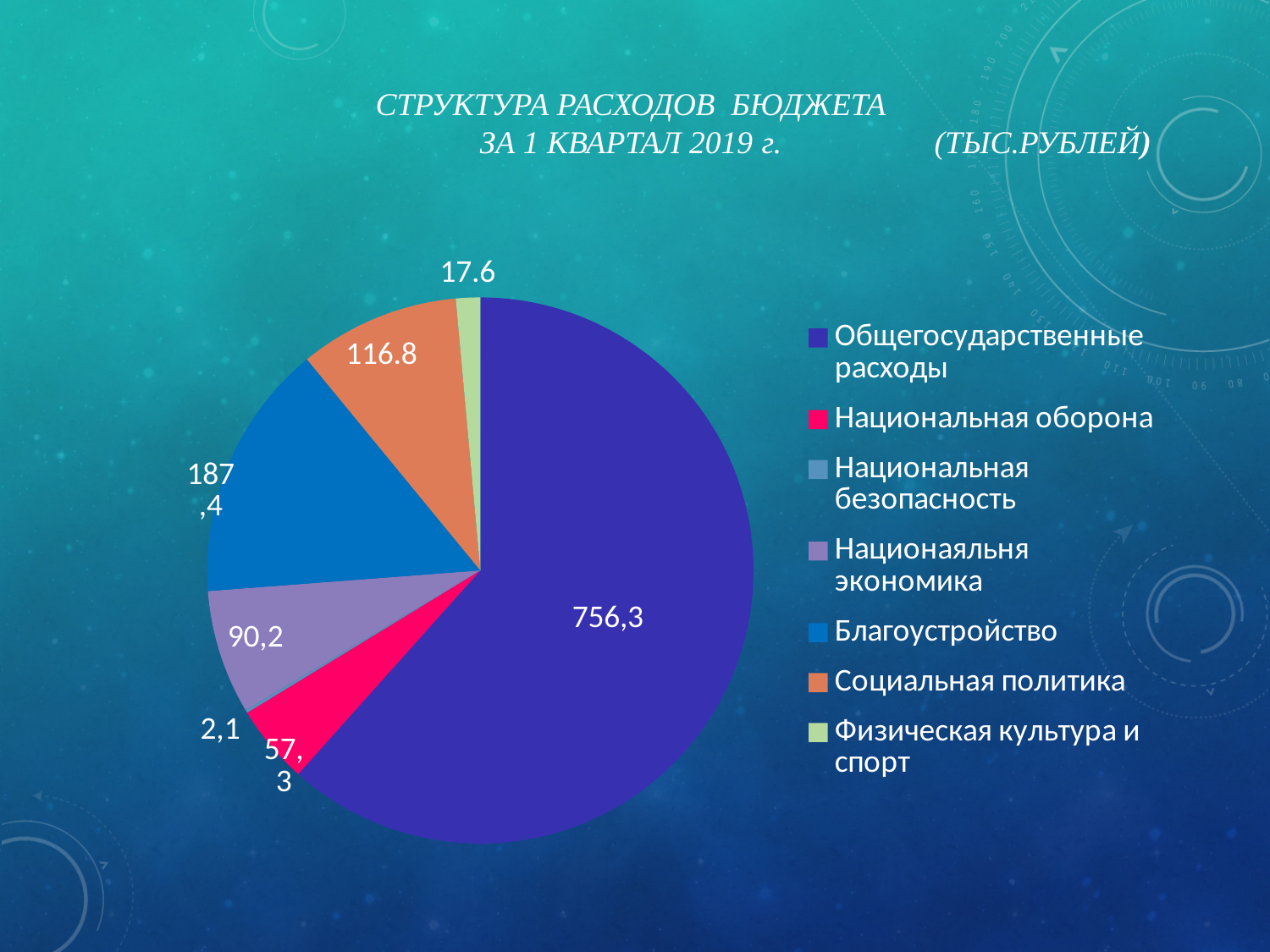
What is the difference between the value for Общегосударственные расходы and the value for Благоустройство? 568,9 What unit is stated in the chart title? тыс.рублей Which is larger, the value for Благоустройство or the value for Социальная политика? Благоустройство What is the value for Социальная политика? 116.8 Which category has the smallest slice of the pie? Национальная безопасность How many slices does the pie chart have? 7 What is the value for Национальная оборона? 57,3 Which category has the largest slice of the pie? Общегосударственные расходы What is the value for Общегосударственные расходы? 756,3 How many entries does the legend list? 7 What is the value for Благоустройство? 187,4 What kind of chart is shown on the slide? pie chart